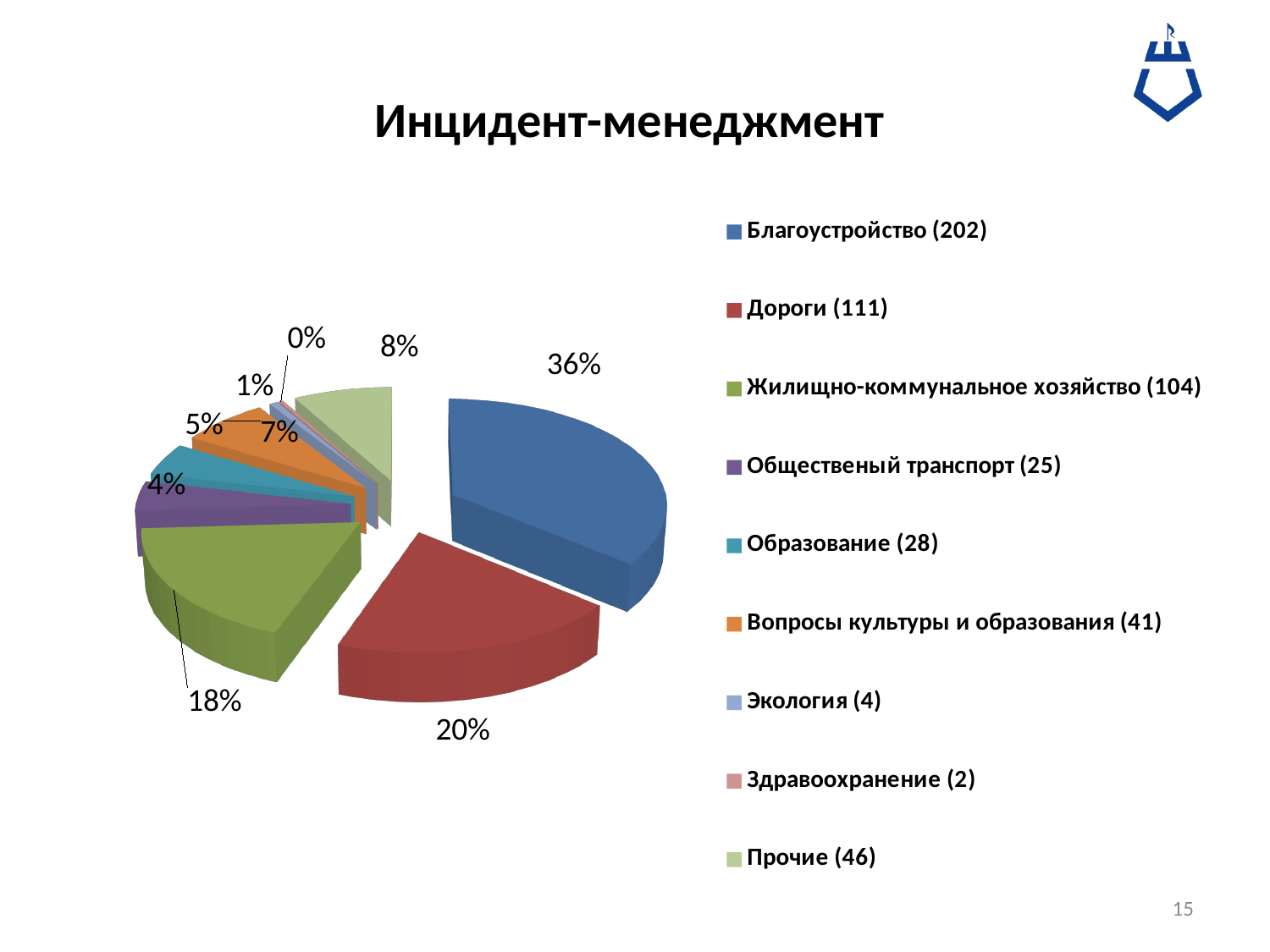
Which slice is larger: Образование (28) or Общественый транспорт (25)? Образование (28) What share of the pie does Дороги (111) have? 20% Which category has the largest slice of the pie? Благоустройство (202) What kind of chart is shown on the slide? pie chart What share of the pie does Благоустройство (202) have? 36% What share of the pie does Прочие (46) have? 8% What is the title of the slide with the pie chart? Инцидент-менеджмент What count is shown in the legend for Вопросы культуры и образования? 41 How many categories does the legend of the pie chart list? 9 Which category has the smallest slice of the pie? Здравоохранение (2) What is the difference in percentage points between the Благоустройство slice and the Дороги slice? 16